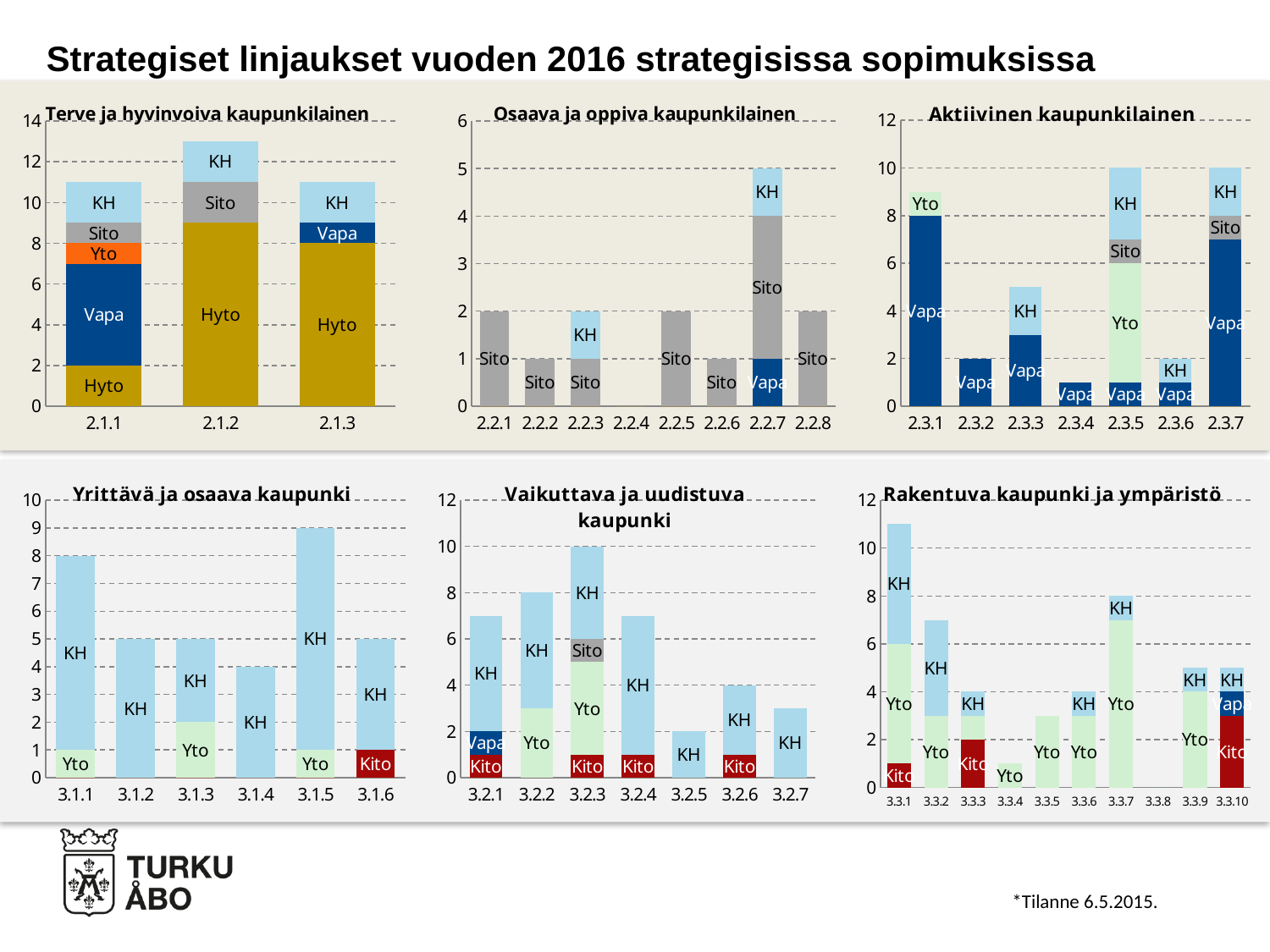
In the 'Aktiivinen kaupunkilainen' chart, is the bar for 2.3.1 greater or less than 8? greater In the 'Terve ja hyvinvoiva kaupunkilainen' chart, which category has the tallest bar? 2.1.2 In the 'Yrittävä ja osaava kaupunki' chart, which category has the tallest bar? 3.1.5 How many categories are shown on the x axis of the 'Osaava ja oppiva kaupunkilainen' chart? 8 In the 'Rakentuva kaupunki ja ympäristö' chart, which bar is taller, 3.3.1 or 3.3.7? 3.3.1 What kind of chart is the 'Rakentuva kaupunki ja ympäristö' chart? Stacked bar chart In the 'Osaava ja oppiva kaupunkilainen' chart, which category has the highest bar? 2.2.7 In the 'Aktiivinen kaupunkilainen' chart, which category has the lowest bar? 2.3.4 In the 'Vaikuttava ja uudistuva kaupunki' chart, which category has the lowest bar? 3.2.5 In the 'Osaava ja oppiva kaupunkilainen' chart, what is the total height of the bar for 2.2.7? 5 In the 'Yrittävä ja osaava kaupunki' chart, what is the difference between the bar heights for 3.1.5 and 3.1.4? 5